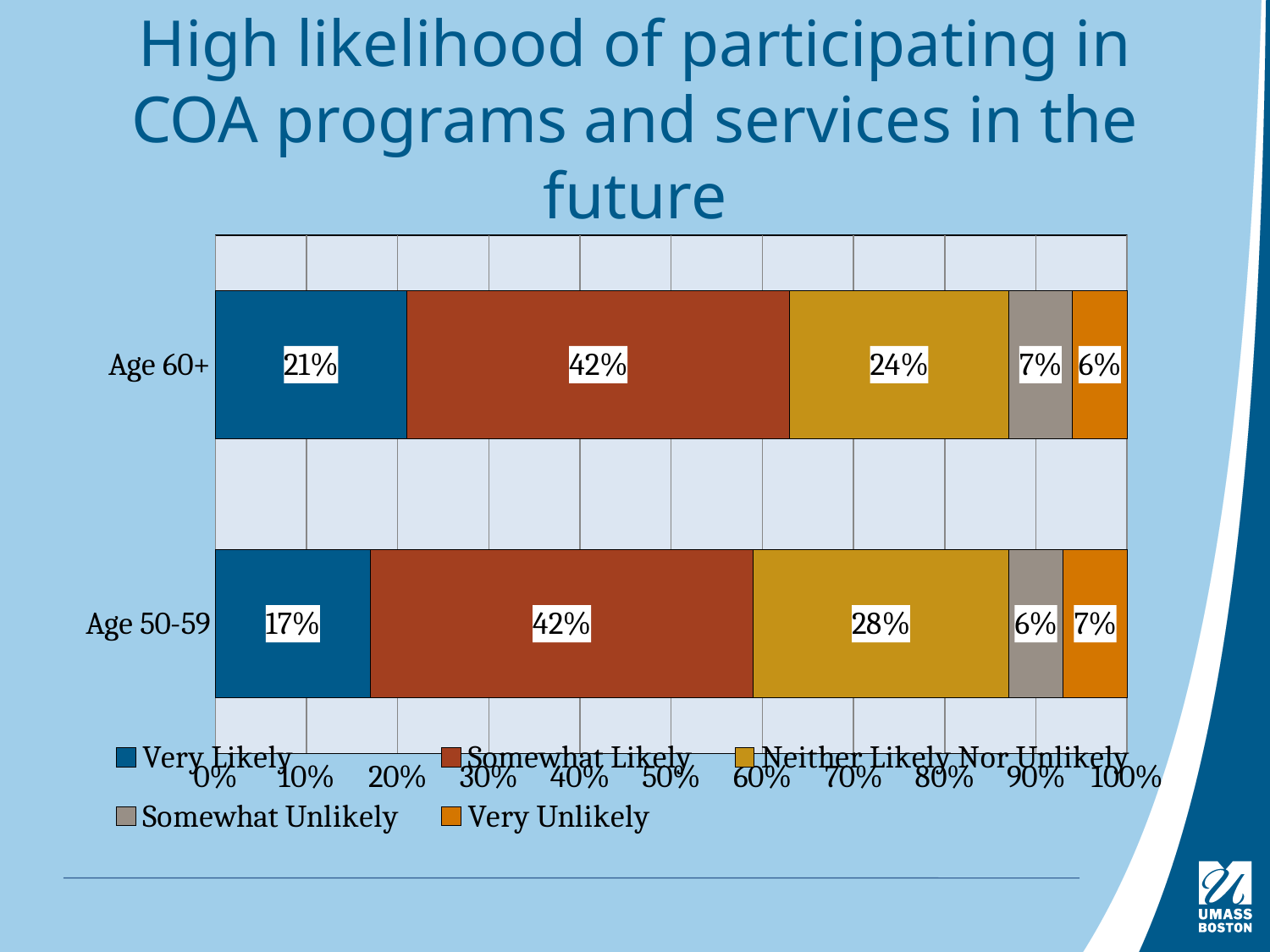
Which response category has the largest share for the Age 50-59 group? Somewhat Likely What type of chart is shown on the slide? Stacked bar chart Which age group has a higher Neither Likely Nor Unlikely percentage? Age 50-59 What percentage of the Age 60+ group is Very Likely to participate? 21% How many series does the legend list? 5 What colour represents the Somewhat Likely series? Red-brown What is the difference between the Very Likely percentages for Age 60+ and Age 50-59? 4 percentage points What percentage of the Age 50-59 group is Very Unlikely to participate? 7% How many age groups are shown in the chart? 2 What percentage of the Age 50-59 group is Neither Likely Nor Unlikely to participate? 28% What percentage of the Age 60+ group is Somewhat Unlikely to participate? 7% Which response category has the smallest share for the Age 60+ group? Very Unlikely